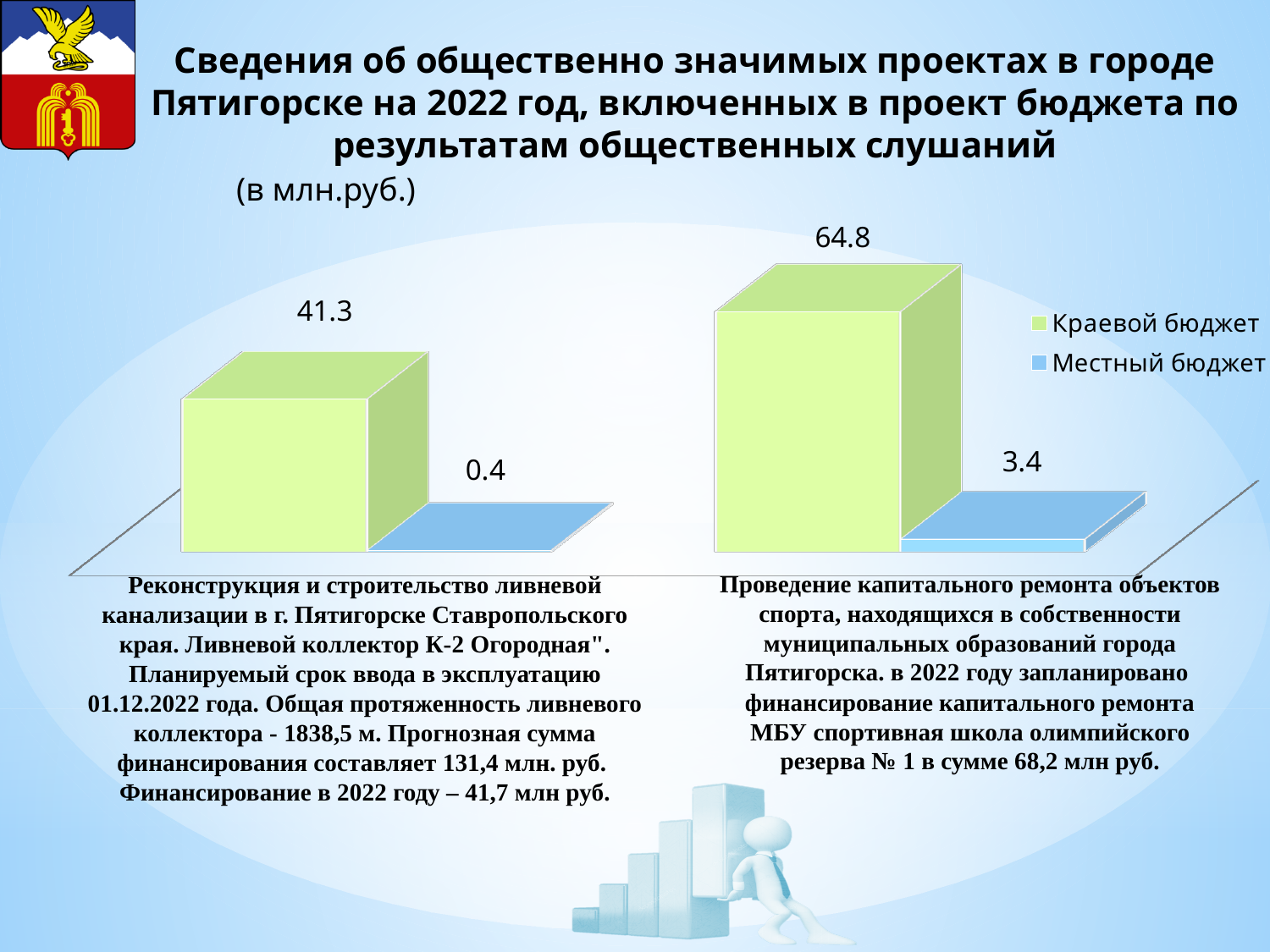
Which project has the lowest Местный бюджет value? Реконструкция и строительство ливневой канализации Which is larger for the sports facilities repair project: Краевой бюджет or Местный бюджет? Краевой бюджет What is the difference between the Краевой бюджет values of the two projects? 23.5 How many projects (categories) are shown in the chart? 2 What kind of chart is shown on the slide? Bar chart What is the value of Краевой бюджет for the storm drainage (ливневая канализация) reconstruction project? 41.3 Which project has the highest Краевой бюджет value? Проведение капитального ремонта объектов спорта How many series does the legend list? 2 What is the difference between the Местный бюджет values of the two projects? 3.0 What is the value of Местный бюджет for the capital repair of sports facilities project? 3.4 What is the value of Краевой бюджет for the capital repair of sports facilities project? 64.8 What is the value of Местный бюджет for the storm drainage (ливневая канализация) reconstruction project? 0.4